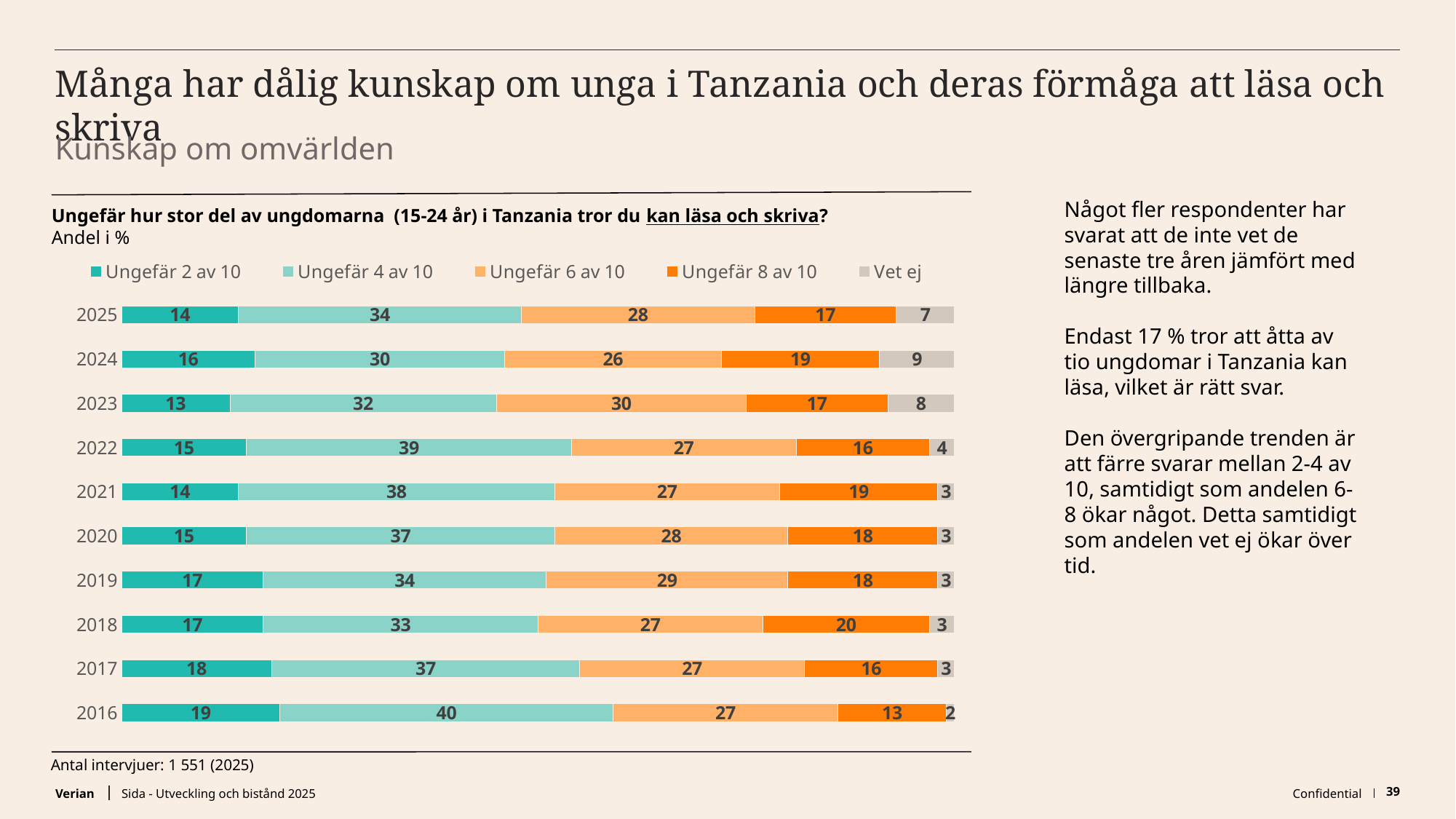
How many years are shown in the chart? 10 Which year has the highest value for "Vet ej"? 2024 What is the total of the stacked bar for 2025? 100 What is the value for "Ungefär 4 av 10" in 2016? 40 What is the difference between the "Vet ej" value in 2024 and in 2025? 2 Which year has the lowest value for "Ungefär 2 av 10"? 2023 What is the value for "Ungefär 8 av 10" in 2025? 17 What is the value for "Vet ej" in 2024? 9 Which is larger: the "Ungefär 4 av 10" value in 2022 or in 2016? 2016 Which year has the highest value for "Ungefär 8 av 10"? 2018 How many series does the legend list? 5 What kind of chart is shown on the slide? Stacked bar chart